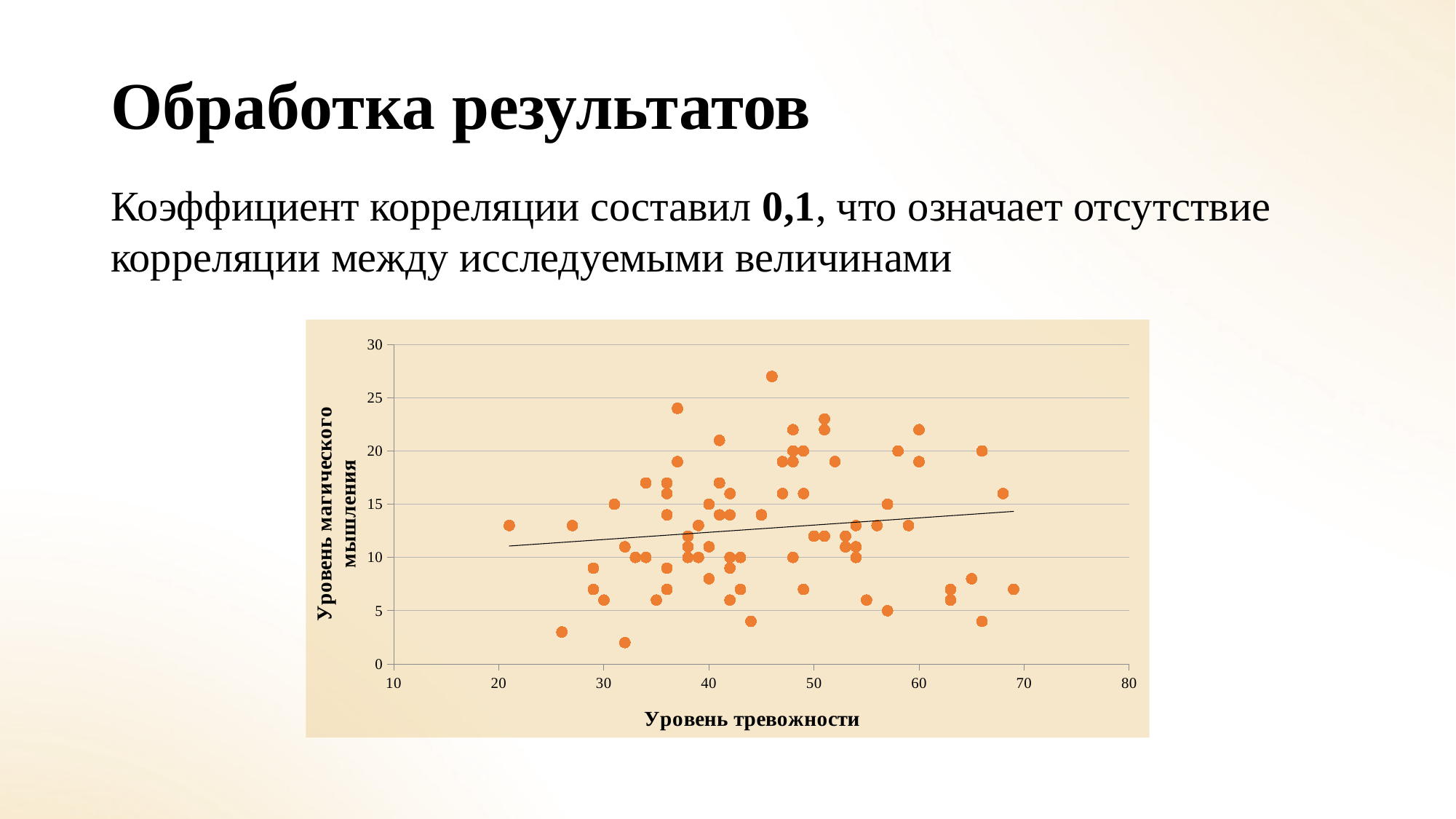
What is the label of the x axis of the chart? Уровень тревожности What kind of chart is shown on the slide? scatter chart Is the x value of the rightmost point in the chart greater or less than 60? greater What is the label of the y axis of the chart? Уровень магического мышления Does the trend line in the chart rise or fall as the x axis value increases? rises Is the y value of the lowest point in the chart greater or less than 5? less What is the minimum value shown on the x axis of the chart? 10 What is the maximum value shown on the y axis of the chart? 30 What is the maximum value shown on the x axis of the chart? 80 Is the y value of the highest point in the chart greater or less than 25? greater